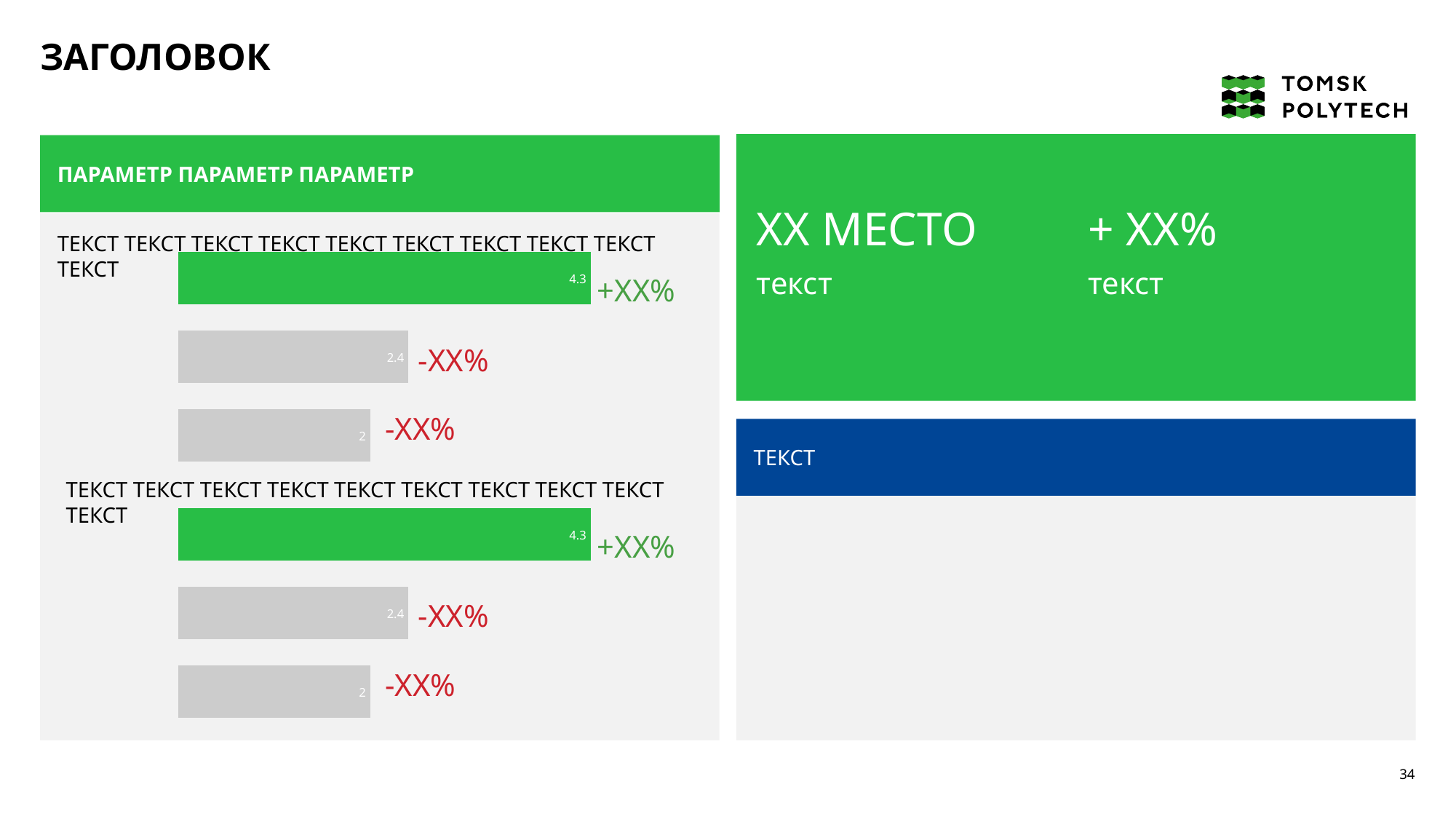
In the lower chart on the left panel, which bar has the lowest value? The bottom bar, 2 In the upper chart on the left panel, what is the value of the middle bar? 2.4 In the lower chart on the left panel, which is larger: the middle bar or the bottom bar? The middle bar (2.4) How many bars does the upper chart on the left panel contain? 3 In the upper chart on the left panel, which bar has the highest value? The top (green) bar, 4.3 In the upper chart on the left panel, what is the value of the bottom bar? 2 What type of chart is shown in the left panel? Bar chart In the lower chart on the left panel, what is the difference between the middle bar and the bottom bar? 0.4 In the lower chart on the left panel, what is the value of the top (green) bar? 4.3 In the upper chart on the left panel, what is the value of the top (green) bar? 4.3 In the lower chart on the left panel, what is the value of the bottom bar? 2 In the upper chart on the left panel, what is the difference between the top bar and the middle bar? 1.9